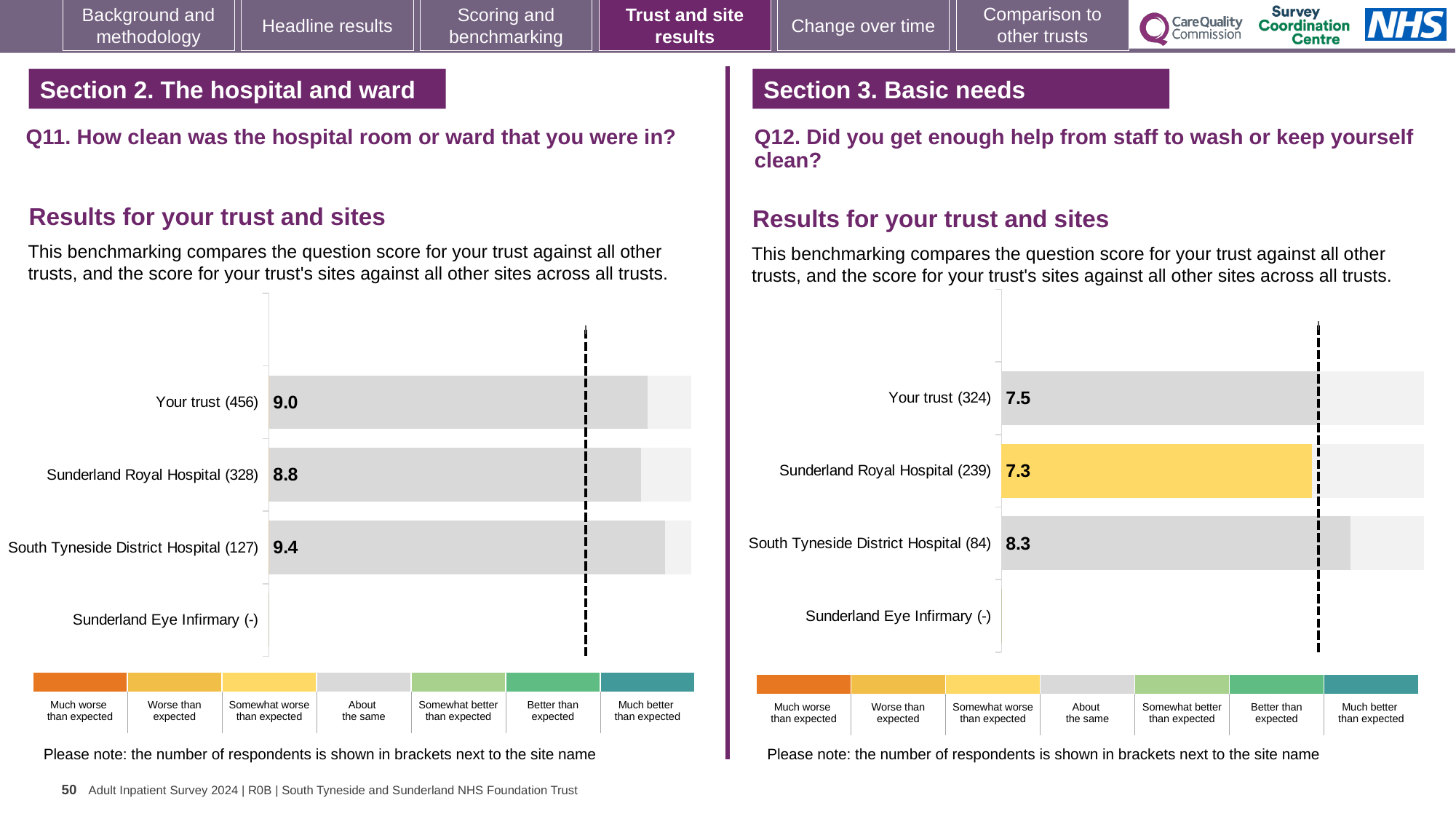
On the Q11 chart (left), what is the score for South Tyneside District Hospital (127)? 9.4 On the Q12 chart (right), which site's bar is coloured yellow (somewhat worse than expected)? Sunderland Royal Hospital (239) How many categories are listed on the Q11 chart (left)? 4 On the Q12 chart (right), what is the difference between the scores for South Tyneside District Hospital (84) and Your trust (324)? 0.8 On the Q12 chart (right), which site or trust has the lowest score? Sunderland Royal Hospital (239) On the Q11 chart (left), what is the difference between the scores for South Tyneside District Hospital (127) and Sunderland Royal Hospital (328)? 0.6 On the Q12 chart (right), what is the score for South Tyneside District Hospital (84)? 8.3 On the Q12 chart (right), which has the larger score, Your trust (324) or Sunderland Royal Hospital (239)? Your trust (324) On the Q11 chart (left), what is the score for Your trust (456)? 9.0 What kind of chart is the Q12 chart (right)? Bar chart On the Q11 chart (left), which site or trust has the highest score? South Tyneside District Hospital (127) On the Q12 chart (right), what is the score for Sunderland Royal Hospital (239)? 7.3